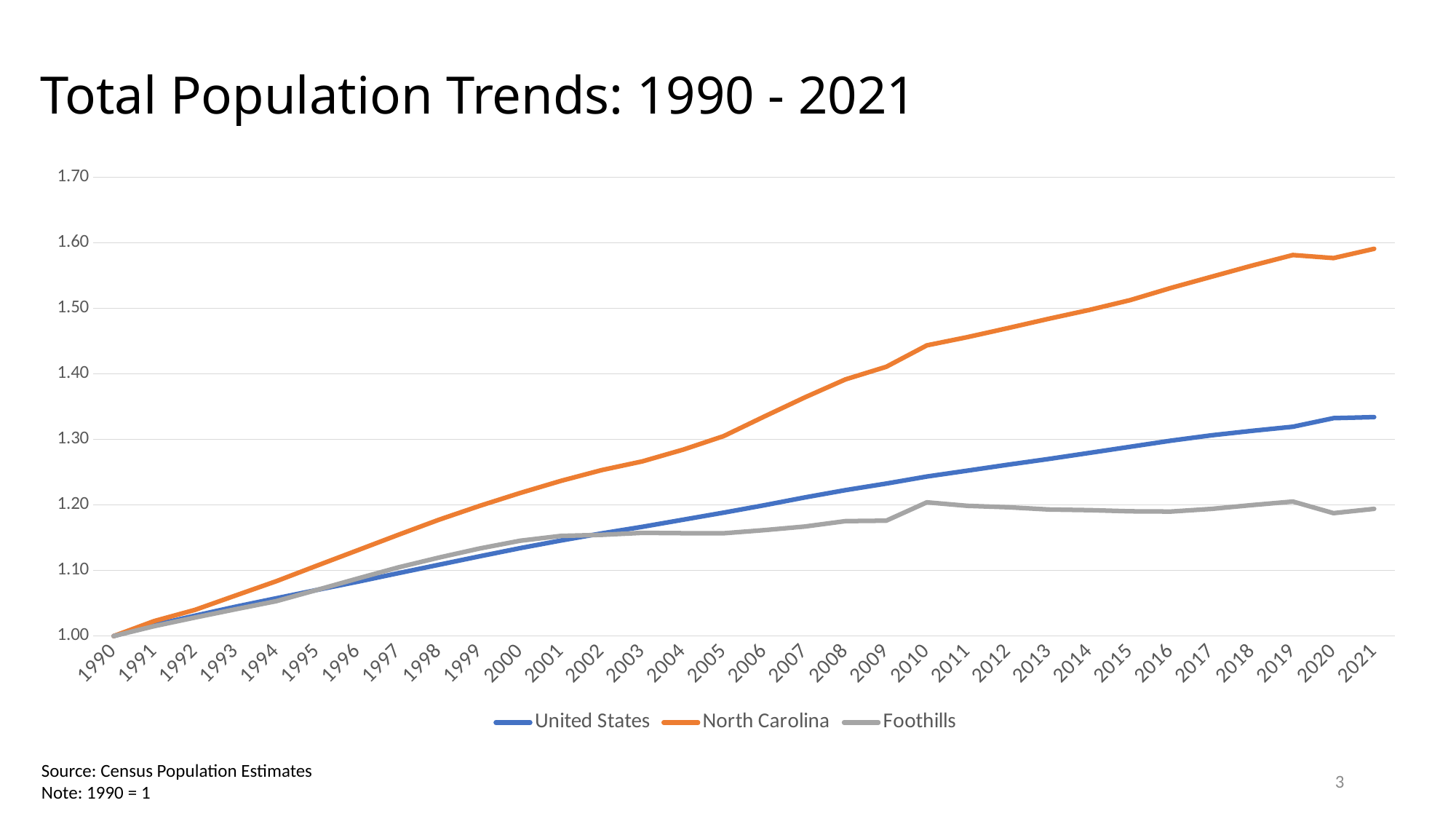
Is the value for United States in 2021 greater or less than 1.40? less Is the value for North Carolina in 2021 greater or less than 1.50? greater Which series has the highest value in 2021? North Carolina How many series does the legend list? 3 What is the value for all three series in 1990? 1.00 How many years are plotted along the x axis? 32 What colour is the North Carolina line in the legend? orange Which series has the lowest value in 2021? Foothills Is the value for Foothills in 2021 greater or less than 1.30? less In 2021, which is larger: the value for United States or the value for Foothills? United States Does the North Carolina line rise or fall from 1990 to 2021? rise What kind of chart is shown on the slide? line chart